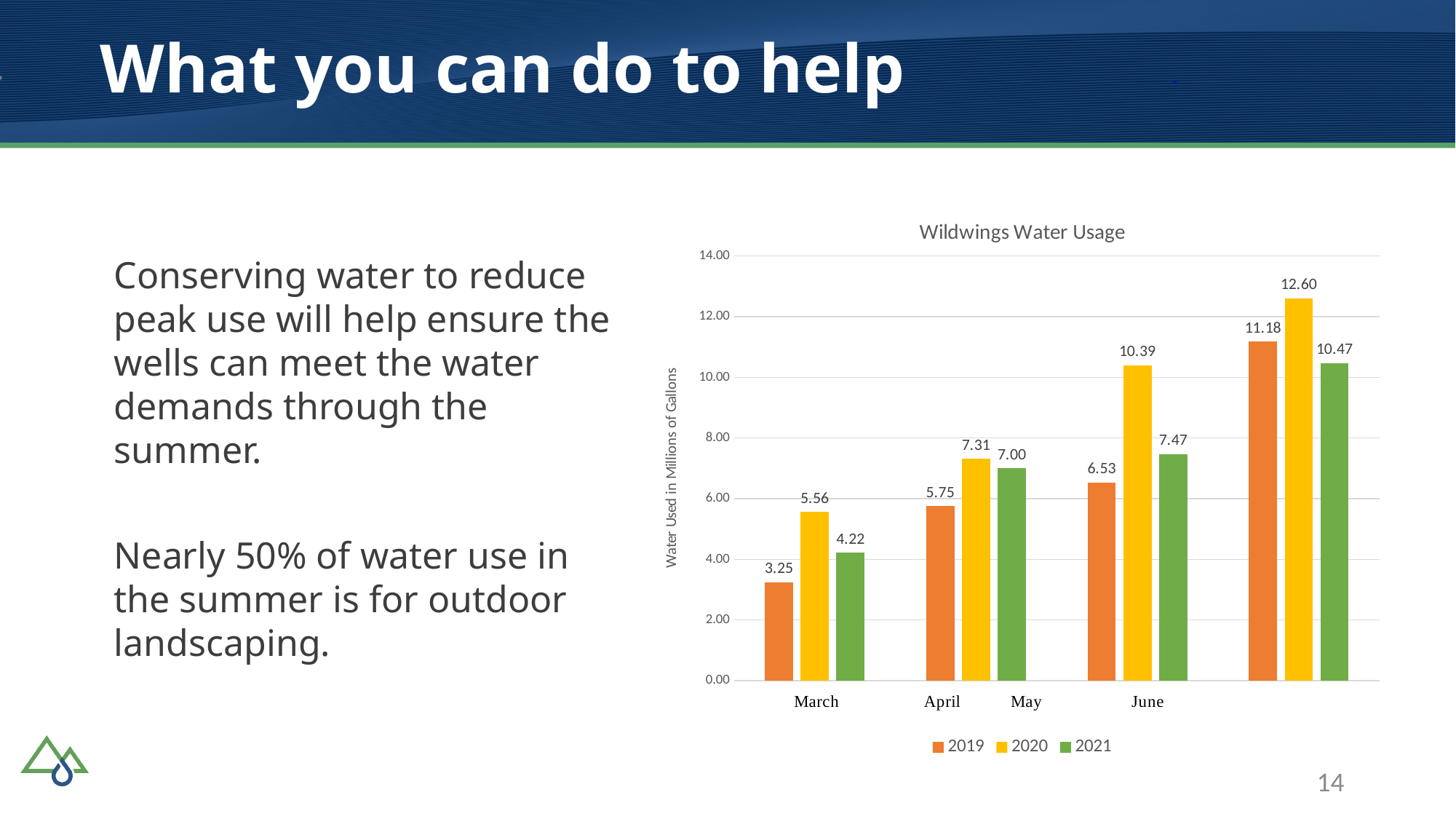
In the Wildwings Water Usage chart, what is the lowest value shown on any bar? 3.25 What is the y-axis title of the Wildwings Water Usage chart? Water Used in Millions of Gallons What kind of chart is the Wildwings Water Usage chart? Bar chart In the Wildwings Water Usage chart, what is the difference between the 2020 and 2021 values for April? 0.31 How many groups of bars are plotted in the Wildwings Water Usage chart? 4 In the Wildwings Water Usage chart, what is the 2019 value for March? 3.25 In the Wildwings Water Usage chart, what is the difference between the 2020 and 2019 values for March? 2.31 In the Wildwings Water Usage chart, which series has the larger value for March, 2020 or 2021? 2020 In the Wildwings Water Usage chart, what is the 2020 value for April? 7.31 How many series does the legend of the Wildwings Water Usage chart list? 3 In the Wildwings Water Usage chart, what is the highest value shown on any bar? 12.60 In the Wildwings Water Usage chart, what is the 2021 value for March? 4.22